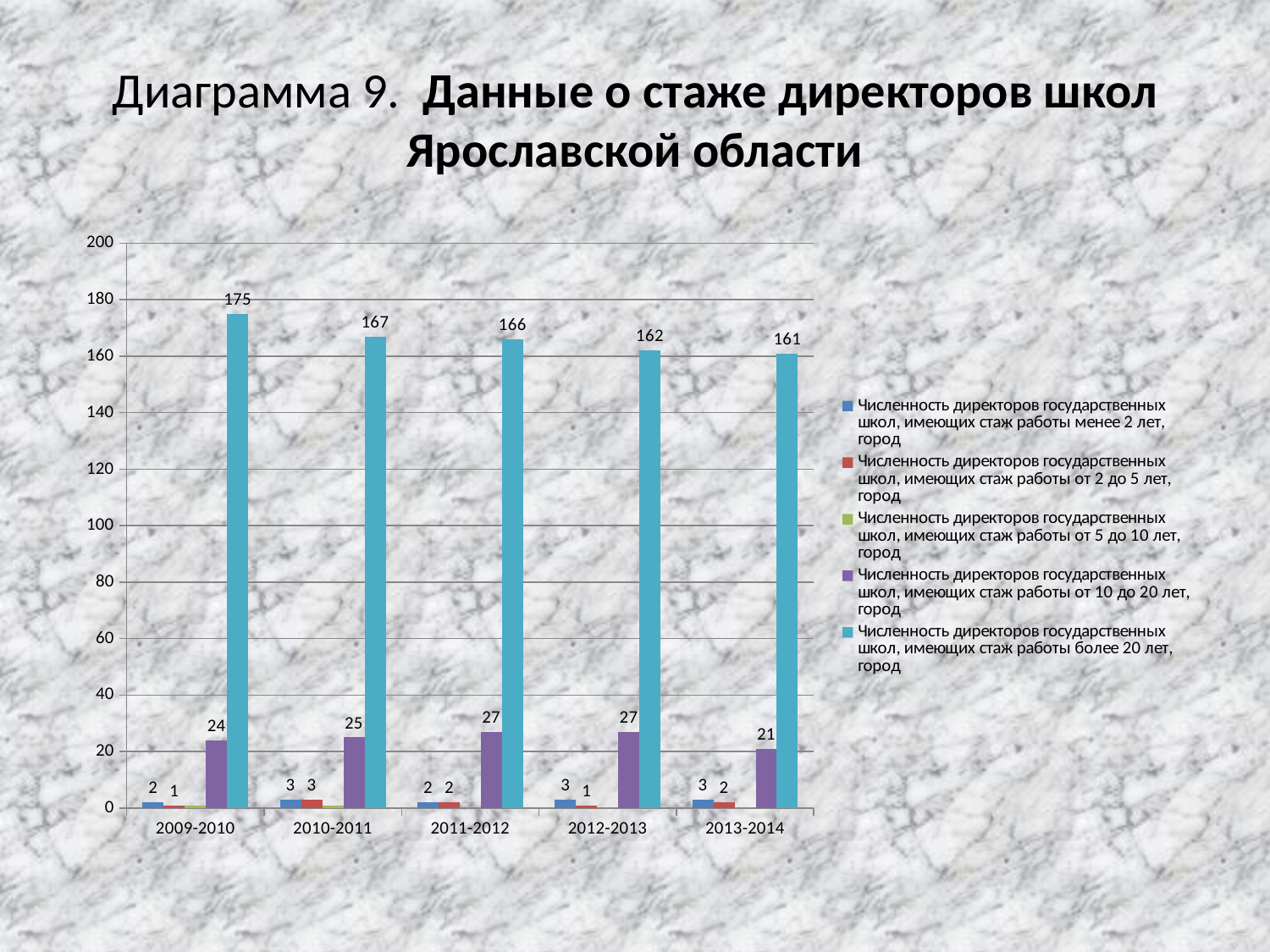
How many series does the legend list? 5 What is the difference between the values for directors with more than 20 years of experience (более 20 лет) in 2009-2010 and 2013-2014? 14 Is the value for directors with more than 20 years of experience (более 20 лет) in 2012-2013 greater or less than 140? greater Which is larger: the value for directors with 10 to 20 years of experience (от 10 до 20 лет) in 2011-2012 or in 2013-2014? 2011-2012 What is the value for directors with 10 to 20 years of experience (от 10 до 20 лет) in 2013-2014? 21 In which year is the value for directors with more than 20 years of experience (более 20 лет) the lowest? 2013-2014 What is the value for directors with less than 2 years of experience (менее 2 лет) in 2010-2011? 3 What kind of chart is shown on the slide? bar chart In which year is the value for directors with more than 20 years of experience (более 20 лет) the highest? 2009-2010 Do the values for directors with more than 20 years of experience (более 20 лет) rise or fall from 2009-2010 to 2013-2014? fall How many year categories are shown on the x axis? 5 What is the value for directors with more than 20 years of experience (более 20 лет) in 2009-2010? 175